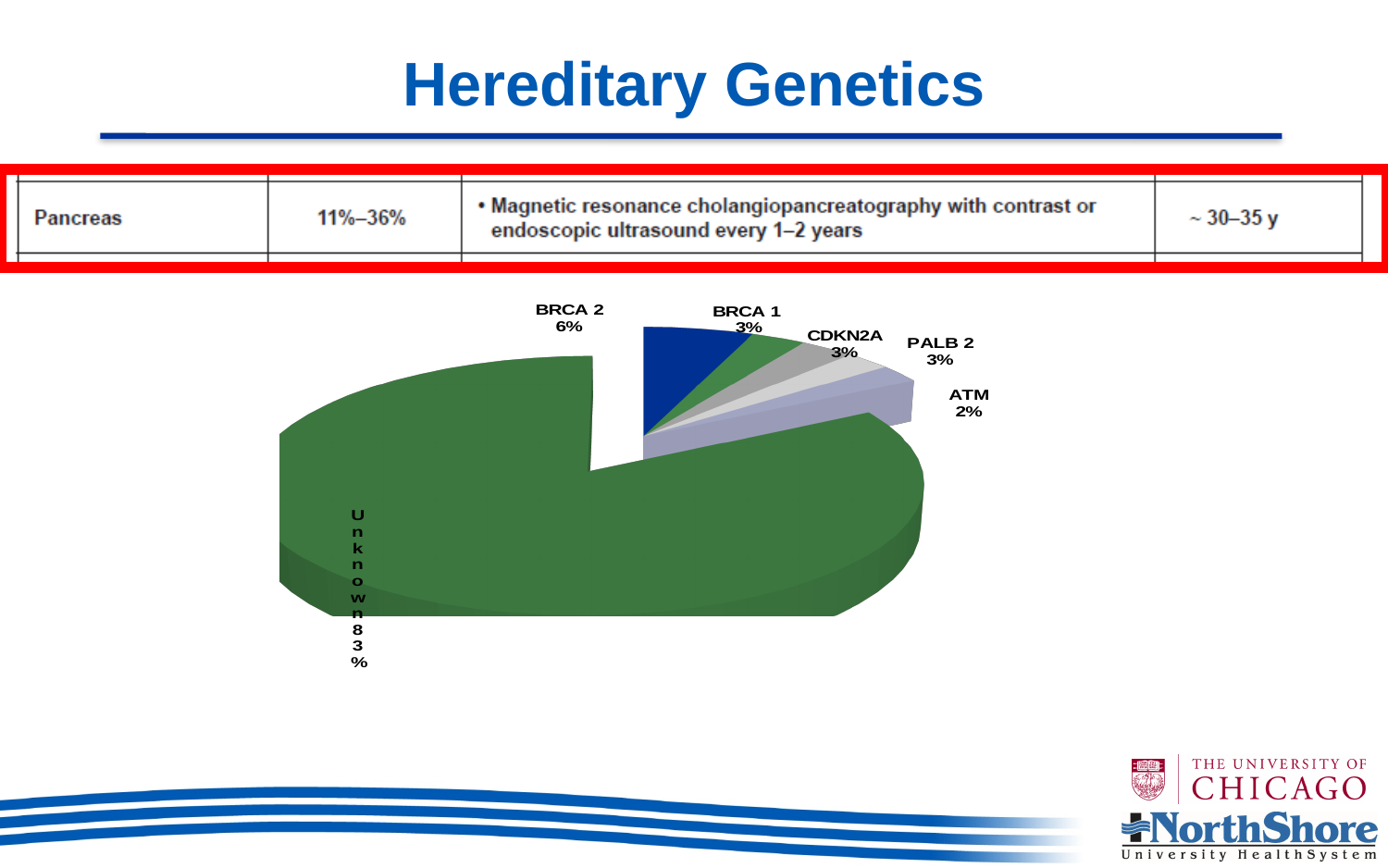
What is the difference in percentage points between the BRCA 2 slice and the BRCA 1 slice? 3 What percentage does the BRCA 2 slice represent in the pie chart? 6% Which slice is larger in the pie chart, BRCA 2 or ATM? BRCA 2 What percentage does the ATM slice represent in the pie chart? 2% What is the difference in percentage points between the Unknown slice and the BRCA 2 slice? 77 What percentage does the CDKN2A slice represent in the pie chart? 3% Which slice of the pie chart is the largest? Unknown What percentage does the Unknown slice represent in the pie chart? 83% What colour is the Unknown slice in the pie chart? green How many slices does the pie chart have? 6 Which slice of the pie chart is the smallest? ATM What kind of chart is shown on the slide? pie chart